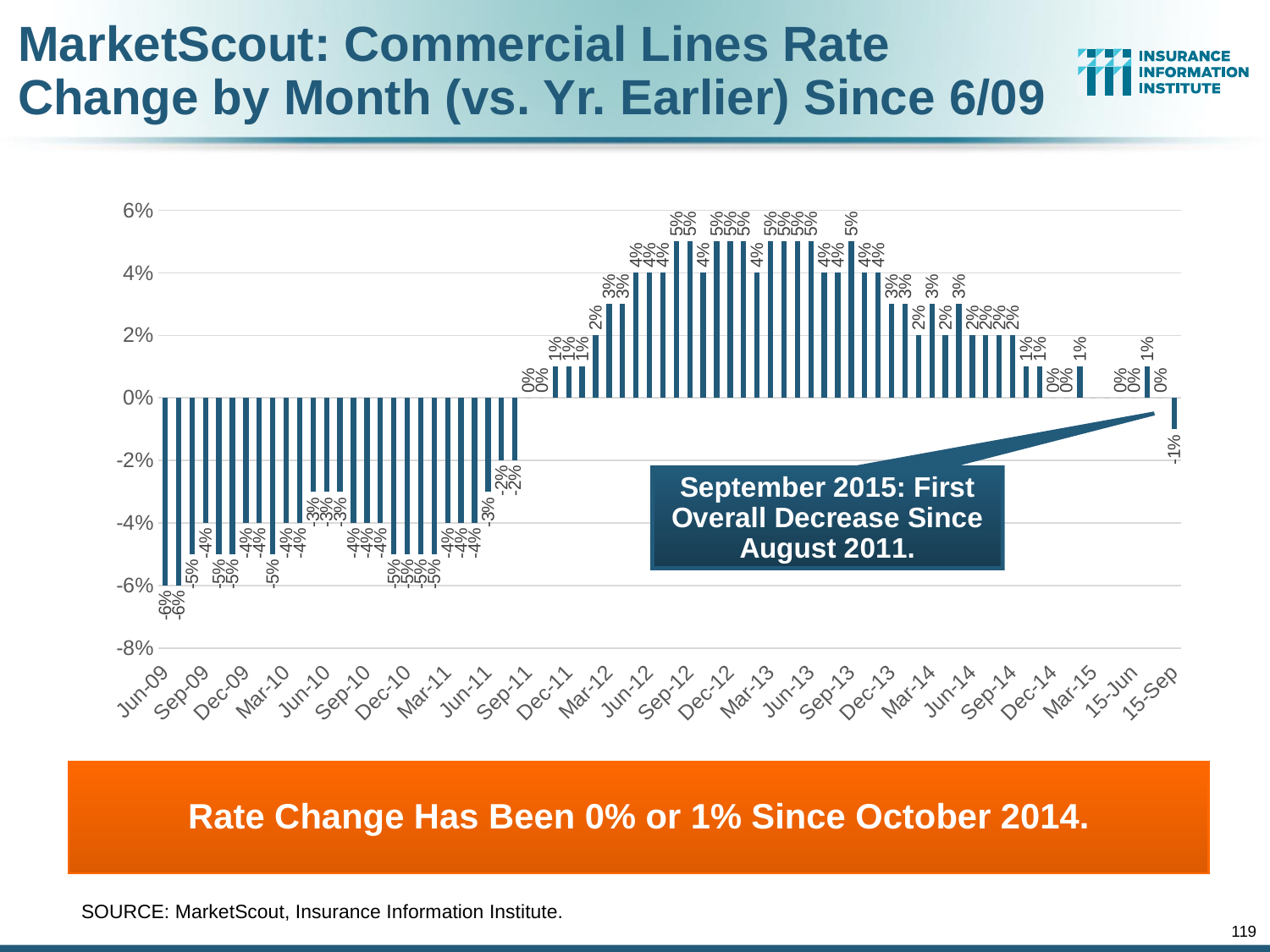
What is the lowest rate change value shown on the chart? -6% Which is larger, the value for Jun-09 or the value for 15-Sep? 15-Sep What is the rate change value for Jun-09, the first bar on the chart? -6% Is the value for Mar-13 greater or less than 2%? greater What kind of chart is shown on the slide? bar chart What is the highest rate change value shown on the chart? 5% What is the difference between the value for 15-Sep (-1%) and the value for Jun-09 (-6%)? 5 percentage points Do the values generally rise or fall along the x axis from Jun-09 to Sep-12? rise According to the callout on the chart, September 2015 was the first overall decrease since which month? August 2011 What is the title of the chart on the slide? MarketScout: Commercial Lines Rate Change by Month (vs. Yr. Earlier) Since 6/09 Is the value for Dec-10 greater or less than -2%? less What is the rate change value for 15-Sep, the last bar on the chart? -1%